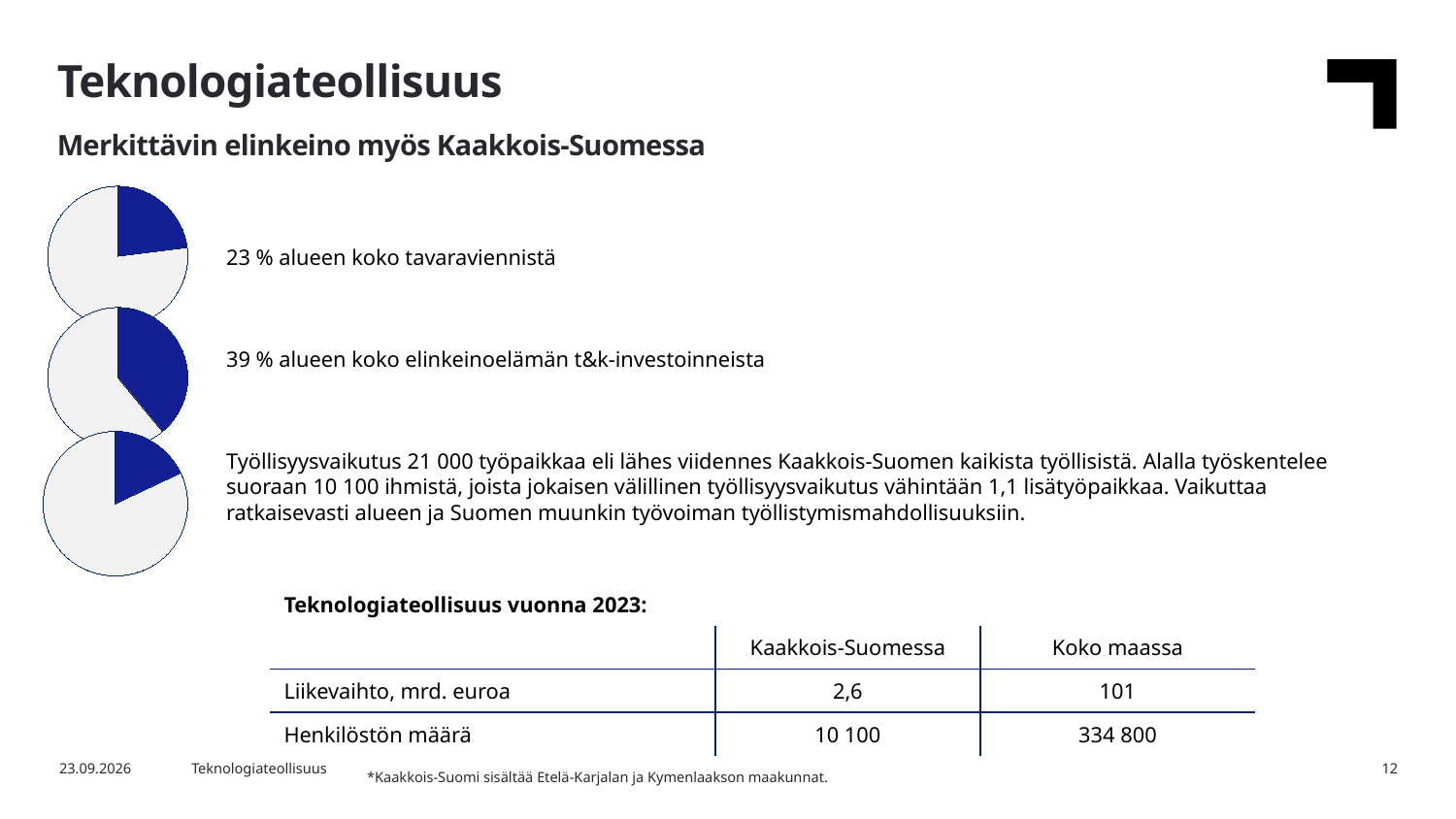
In the middle pie chart, what share does the blue slice represent (share of the region's business R&D investments)? 39 % In the top pie chart, what share does the blue slice represent (share of the region's total goods exports)? 23 % How many pie charts are on the slide? 3 Is the blue slice larger in the top pie chart or in the middle pie chart? The middle pie chart What kind of charts are shown on the left side of the slide? Pie charts What is the difference in percentage points between the blue slice of the middle pie chart (39 %) and the blue slice of the top pie chart (23 %)? 16 percentage points What colour is the highlighted slice in each pie chart? Blue What does the top pie chart illustrate, according to the text next to it? 23 % alueen koko tavaraviennistä Which of the three pie charts has the largest blue slice? The middle one (39 %) How many slices does each pie chart have? 2